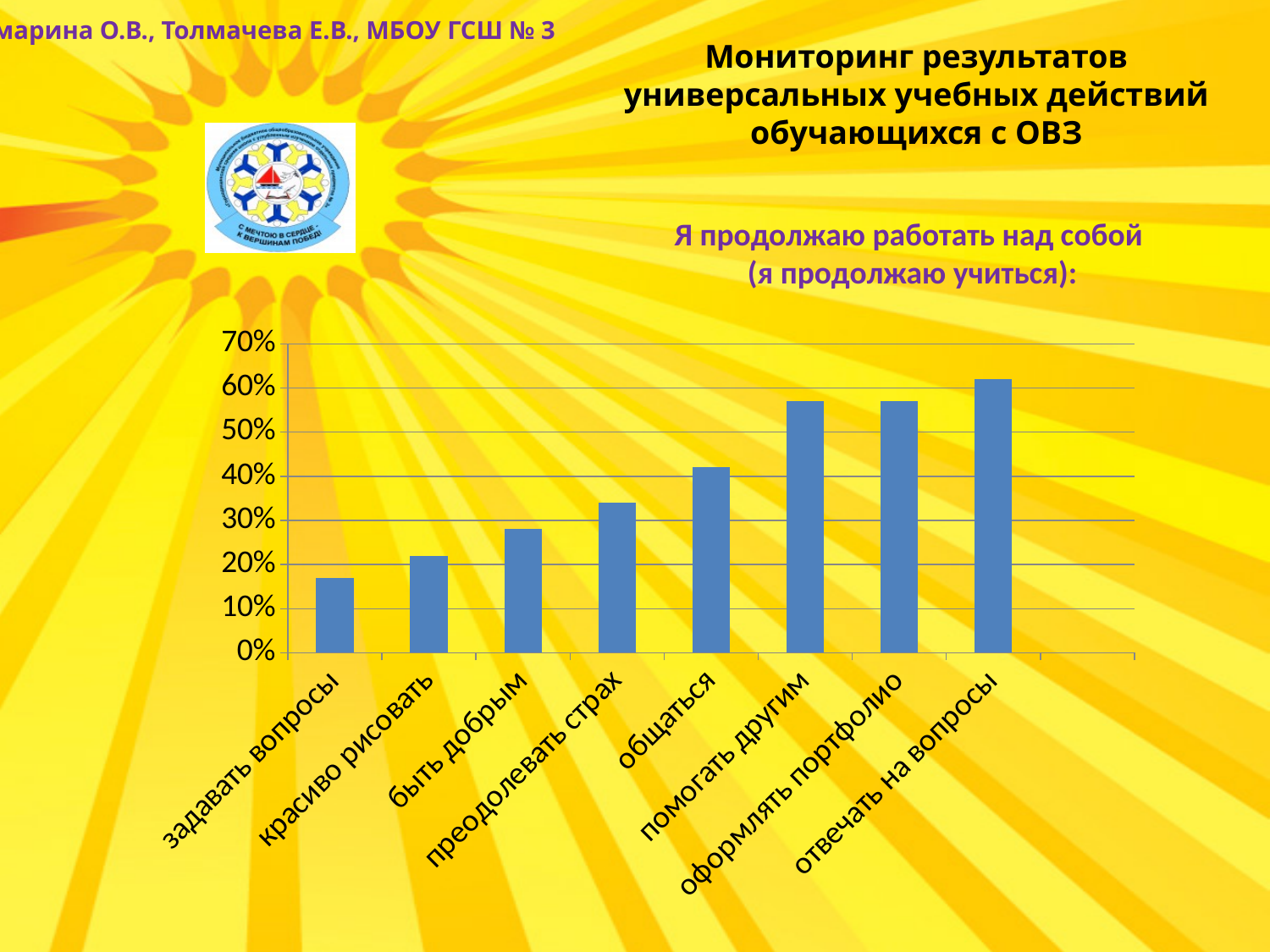
Which category has the lowest bar in the chart? задавать вопросы How many categories are shown on the x axis of the chart? 8 Is the value for "общаться" greater or less than 40%? greater Which is larger, the value for "общаться" or the value for "быть добрым"? общаться Is the value for "быть добрым" greater or less than 30%? less Is the value for "преодолевать страх" greater or less than 30%? greater What is the highest value shown on the chart's vertical axis? 70% What kind of chart is shown on the slide? bar chart Do the bar values generally rise or fall from left to right along the x axis? rise Which category has the highest bar in the chart? отвечать на вопросы